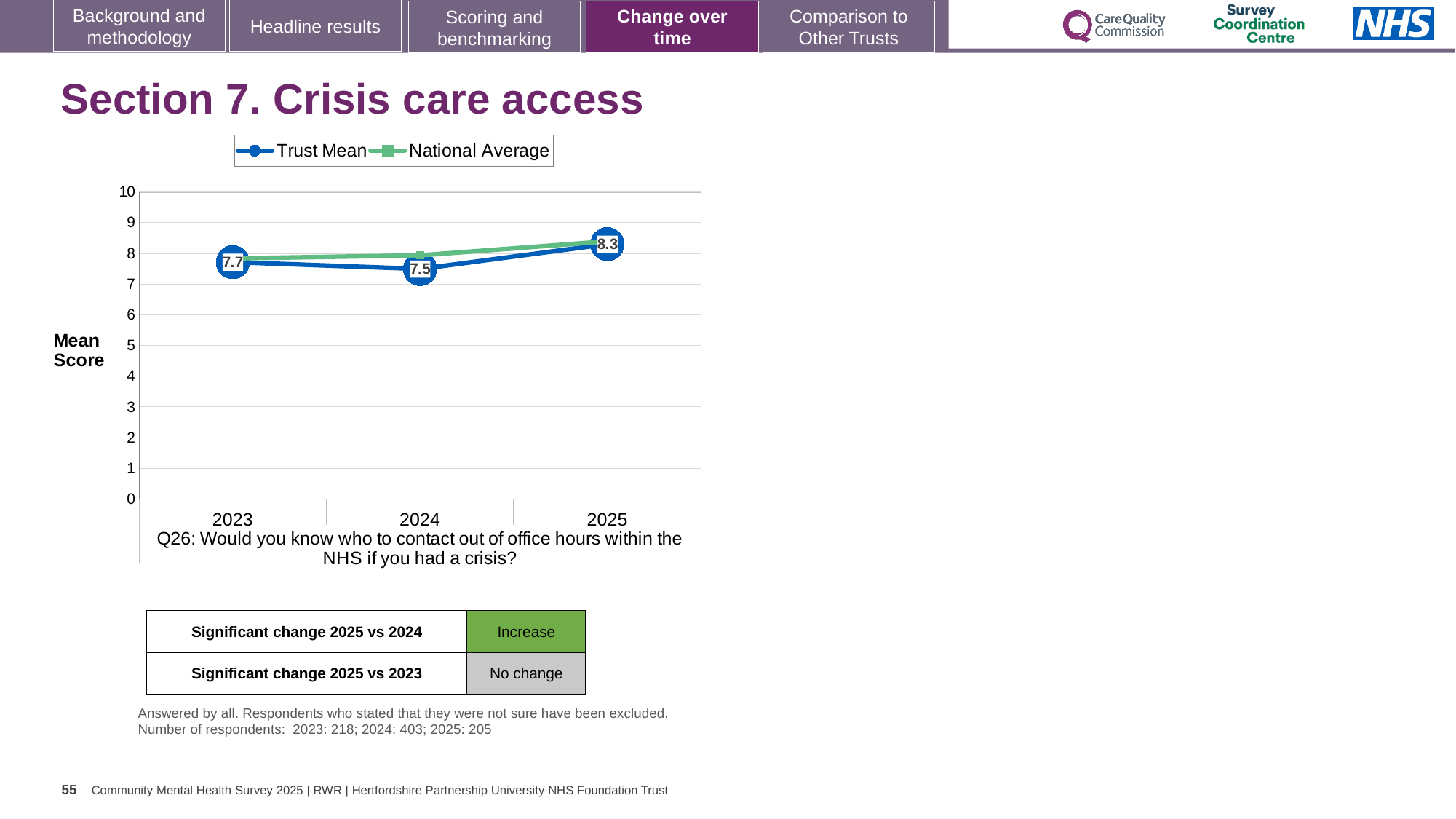
What is the Trust Mean for 2023? 7.7 How many series does the legend list? 2 What is the difference between the Trust Mean in 2025 and in 2024? 0.8 In which year is the Trust Mean highest? 2025 Is the National Average for 2025 greater or less than 8? greater What is the Trust Mean for 2025? 8.3 How many years are plotted on the x axis? 3 In which year is the Trust Mean lowest? 2024 Which is larger in 2024, the Trust Mean or the National Average? National Average Does the Trust Mean rise or fall from 2024 to 2025? rise What is the Trust Mean for 2024? 7.5 What kind of chart is shown on the slide? line chart